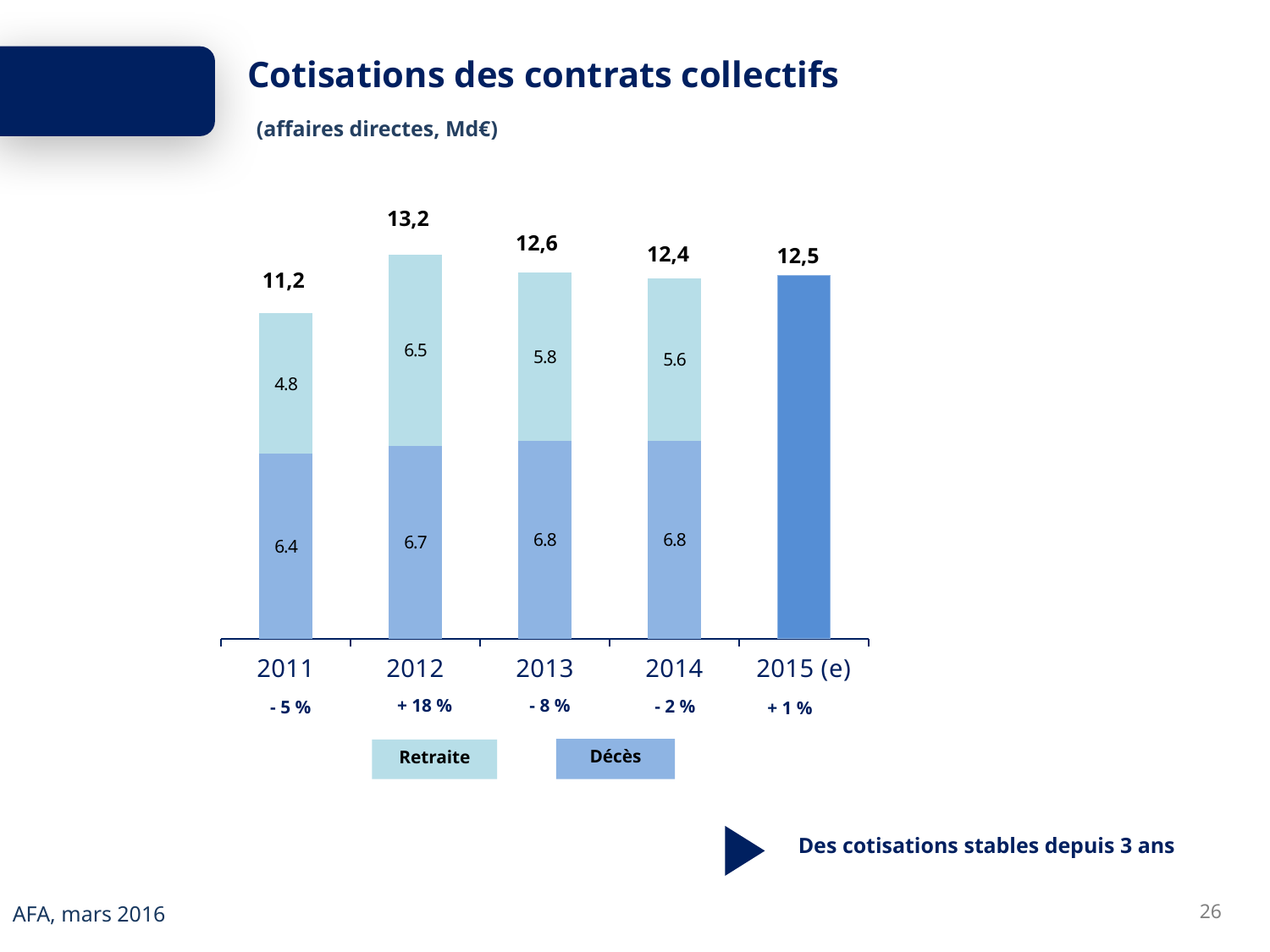
What is the total shown above the bar for 2015 (e)? 12,5 Which year has the lowest total cotisations? 2011 How many series does the legend list? 2 What is the Décès value for 2011? 6.4 What is the difference between the Retraite values for 2012 and 2014? 0.9 What is the title of the chart? Cotisations des contrats collectifs How many years are shown on the x axis? 5 What percentage change is shown under the 2012 bar? + 18 % What is the Retraite value for 2012? 6.5 Which is larger in 2013, the Retraite value or the Décès value? Décès Which year has the highest total cotisations? 2012 What kind of chart is shown on the slide? Stacked bar chart